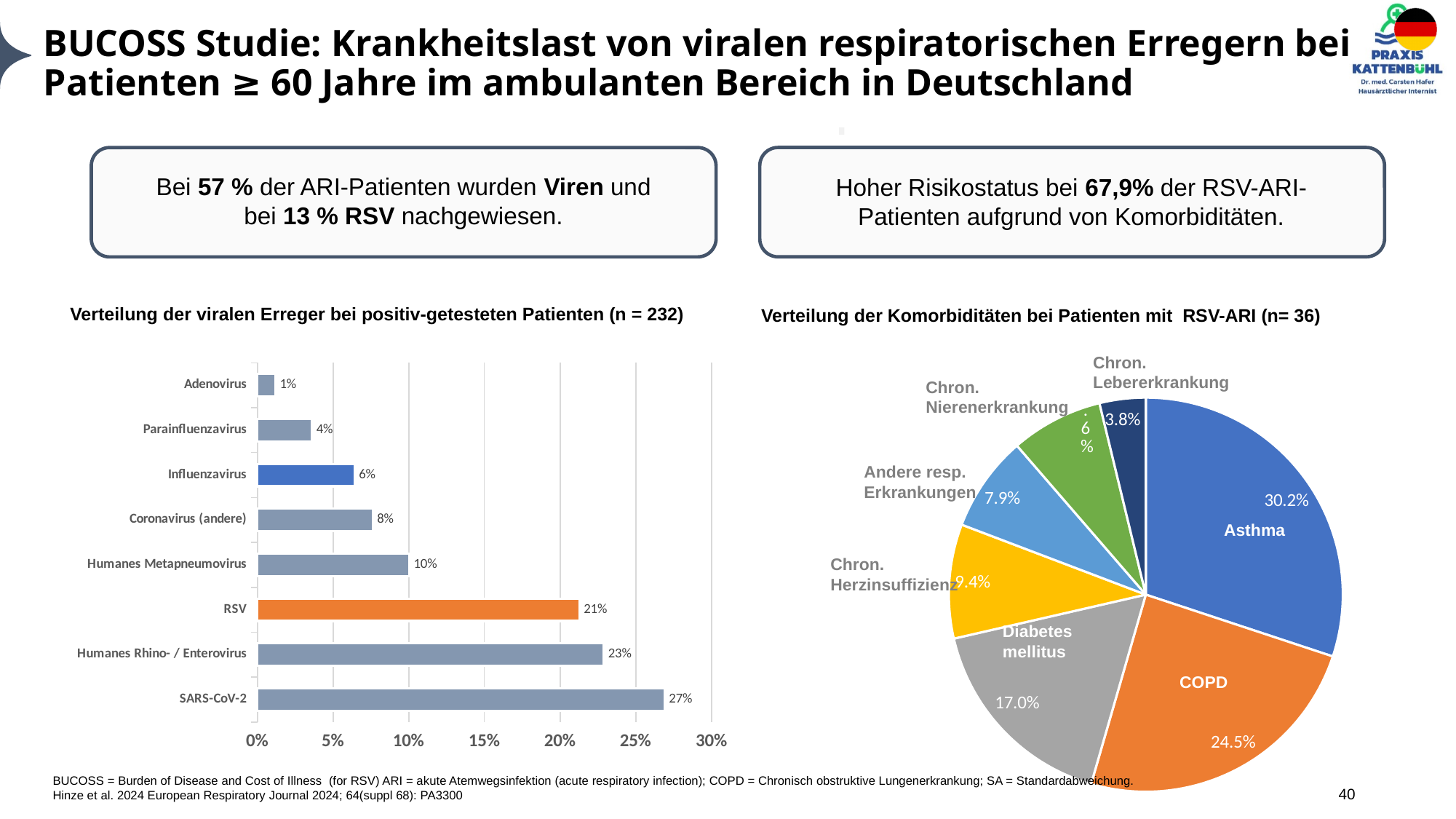
In the pie chart 'Verteilung der Komorbiditäten bei Patienten mit RSV-ARI', what is the value for COPD? 24.5% In the bar chart 'Verteilung der viralen Erreger bei positiv-getesteten Patienten', how many pathogen categories are shown? 8 In the bar chart 'Verteilung der viralen Erreger bei positiv-getesteten Patienten', what is the difference between Humanes Rhino- / Enterovirus and RSV? 2% In the bar chart 'Verteilung der viralen Erreger bei positiv-getesteten Patienten', what is the value for RSV? 21% What kind of chart is the left chart 'Verteilung der viralen Erreger bei positiv-getesteten Patienten'? Bar chart In the pie chart 'Verteilung der Komorbiditäten bei Patienten mit RSV-ARI', what share does Asthma have? 30.2% In the bar chart 'Verteilung der viralen Erreger bei positiv-getesteten Patienten', which pathogen has the highest value? SARS-CoV-2 In the bar chart 'Verteilung der viralen Erreger bei positiv-getesteten Patienten', which pathogen has the lowest value? Adenovirus In the pie chart 'Verteilung der Komorbiditäten bei Patienten mit RSV-ARI', which comorbidity has the smallest slice? Chron. Lebererkrankung In the bar chart 'Verteilung der viralen Erreger bei positiv-getesteten Patienten', which is larger: Influenzavirus or Coronavirus (andere)? Coronavirus (andere) In the bar chart 'Verteilung der viralen Erreger bei positiv-getesteten Patienten', what is the value for SARS-CoV-2? 27% In the pie chart 'Verteilung der Komorbiditäten bei Patienten mit RSV-ARI', what is the difference between Diabetes mellitus and Chron. Herzinsuffizienz? 7.6%